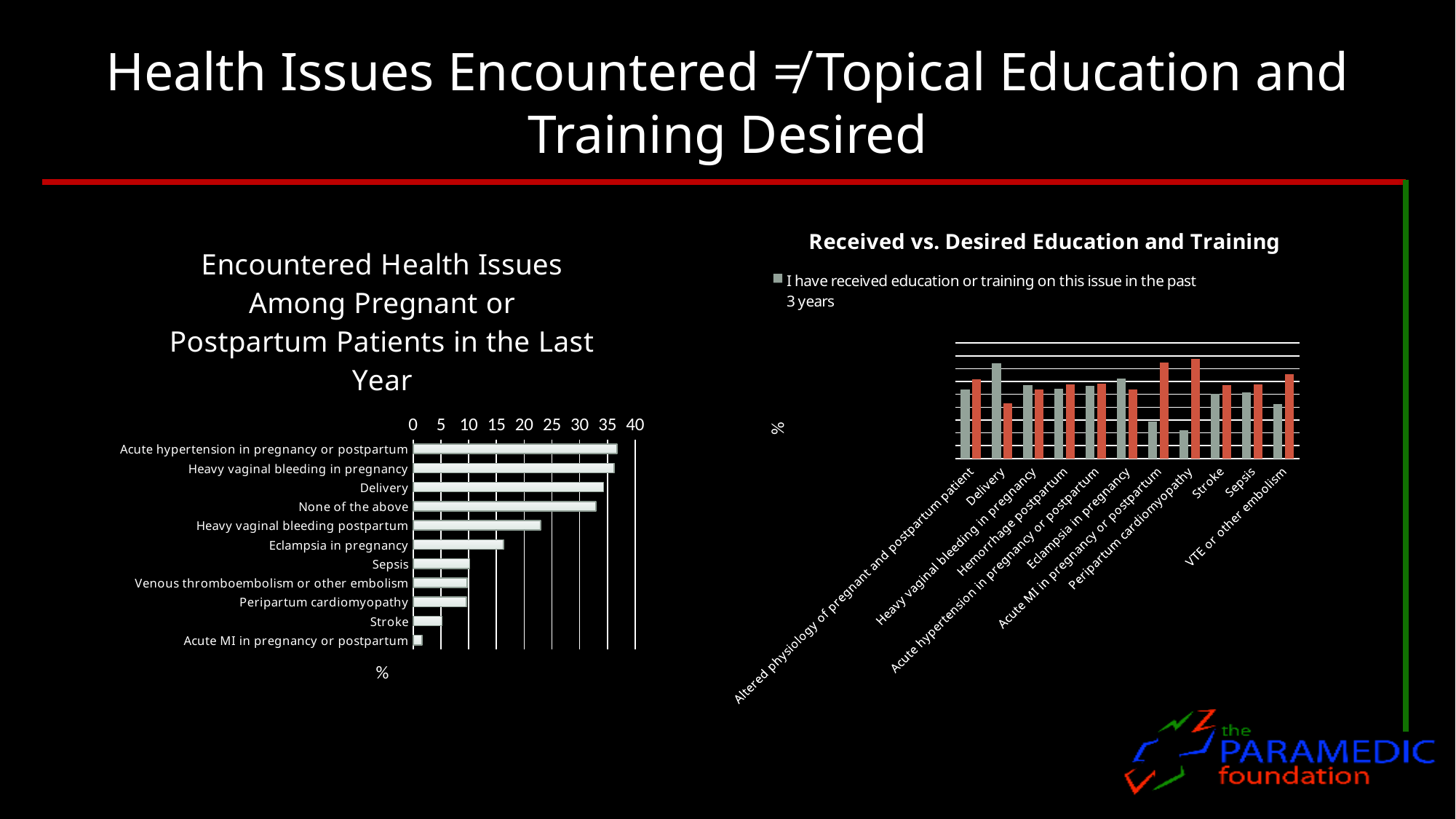
How many categories are shown on the x axis of the 'Received vs. Desired Education and Training' chart? 11 In the 'Encountered Health Issues' chart, is the value for Eclampsia in pregnancy greater or less than 20? less In the 'Received vs. Desired Education and Training' chart, which category has the tallest red bar? Peripartum cardiomyopathy In the 'Encountered Health Issues' chart, which is larger: Heavy vaginal bleeding postpartum or Eclampsia in pregnancy? Heavy vaginal bleeding postpartum In the 'Encountered Health Issues' chart, is the value for Heavy vaginal bleeding postpartum greater or less than 20? greater In the 'Encountered Health Issues' chart, which category has the lowest value? Acute MI in pregnancy or postpartum In the 'Encountered Health Issues' chart, is the value for Stroke greater or less than 10? less In the 'Received vs. Desired Education and Training' chart, for Delivery, which bar is taller: the grey bar or the red bar? The grey bar In the 'Encountered Health Issues' chart, what is the highest value shown on the horizontal axis? 40 What kind of chart is the 'Encountered Health Issues Among Pregnant or Postpartum Patients in the Last Year' chart? Bar chart How many health issue categories are listed in the 'Encountered Health Issues Among Pregnant or Postpartum Patients in the Last Year' chart? 11